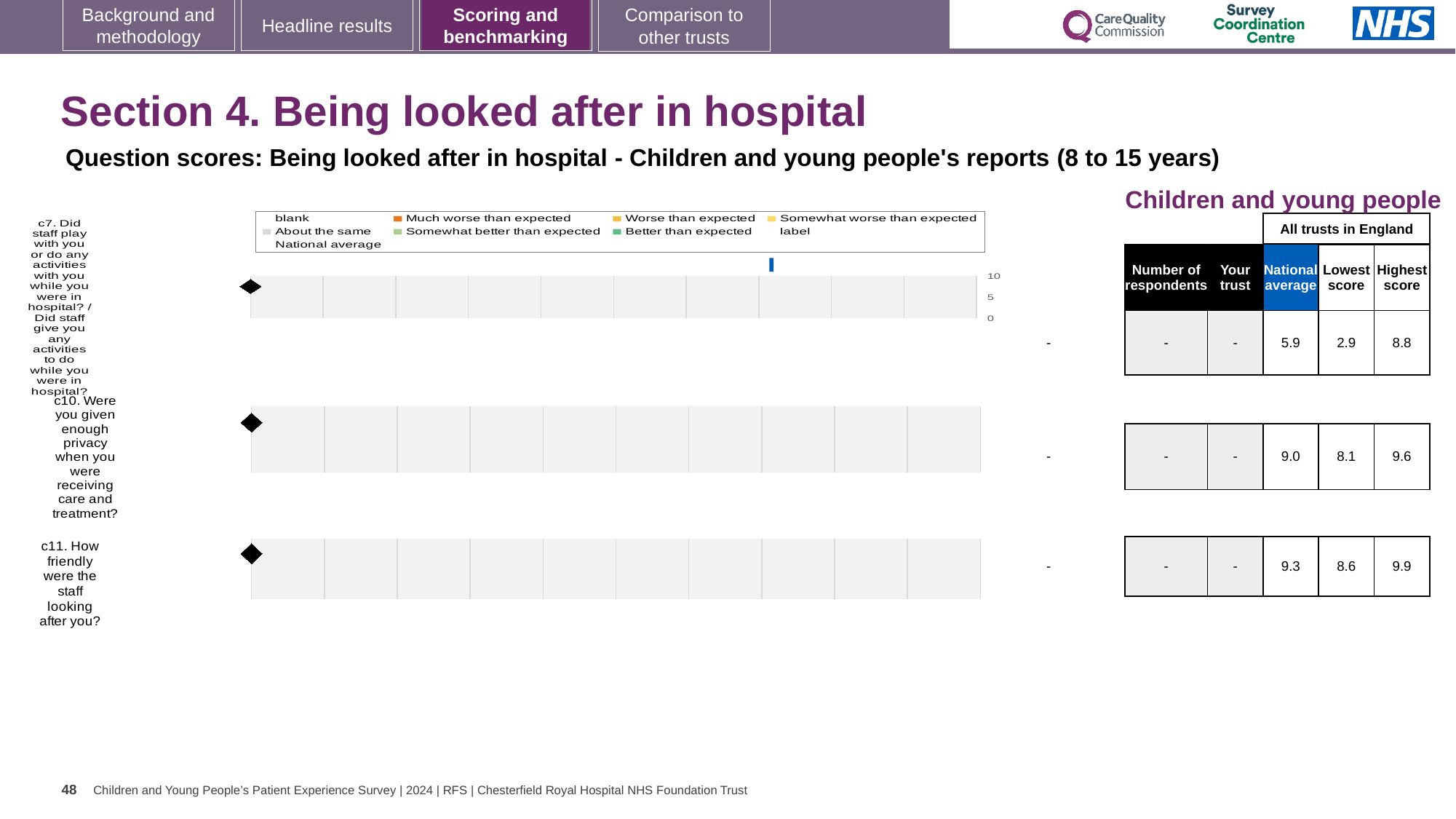
What value is shown for 'Your trust' for c11 in the table? - What is the difference between the Highest score and Lowest score for c10 in the table? 1.5 Is the National average for c7 in the table larger or smaller than the National average for c10? smaller What kind of chart is used for the c11 'How friendly were the staff looking after you?' row? bar chart In the chart legend, what colour is used for 'Much worse than expected'? orange In the table next to the c11 friendliness chart, what is the Highest score? 9.9 In the table next to the c10 privacy chart, what is the National average score? 9.0 How many question rows (charts) are shown on the slide? 3 Which question row has the highest National average score in the table: c7, c10 or c11? c11 Which question row has the lowest National average score in the table: c7, c10 or c11? c7 In the table next to the c7 activities chart, what is the Lowest score? 2.9 What is the highest value shown on the axis of the top chart (c7)? 10